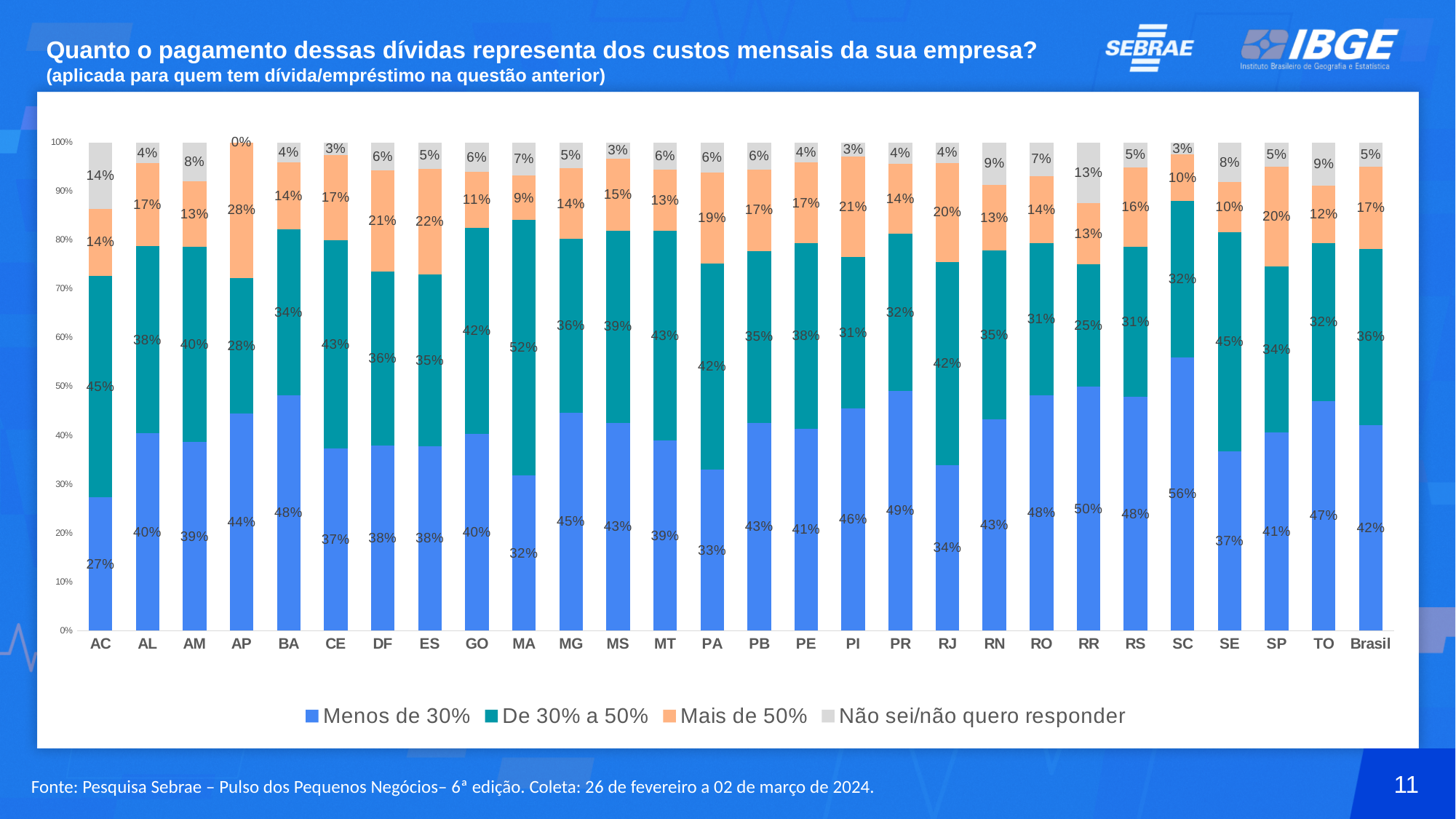
What kind of chart is shown on the slide? Stacked bar chart What is the value of "Menos de 30%" for Brasil? 42% What is the value of "De 30% a 50%" for MA? 52% What is the value of "Não sei/não quero responder" for RR? 13% Which category has the highest value for "Menos de 30%"? SC How many categories are shown on the x axis? 28 How many series does the legend list? 4 What is the value of "Mais de 50%" for DF? 21% Which category has the lowest value for "Menos de 30%"? AC What is the difference between the "Menos de 30%" values for SC and AC? 29 percentage points Which category has the highest value for "Mais de 50%"? AP Which is larger: the "De 30% a 50%" value for CE or for PR? CE